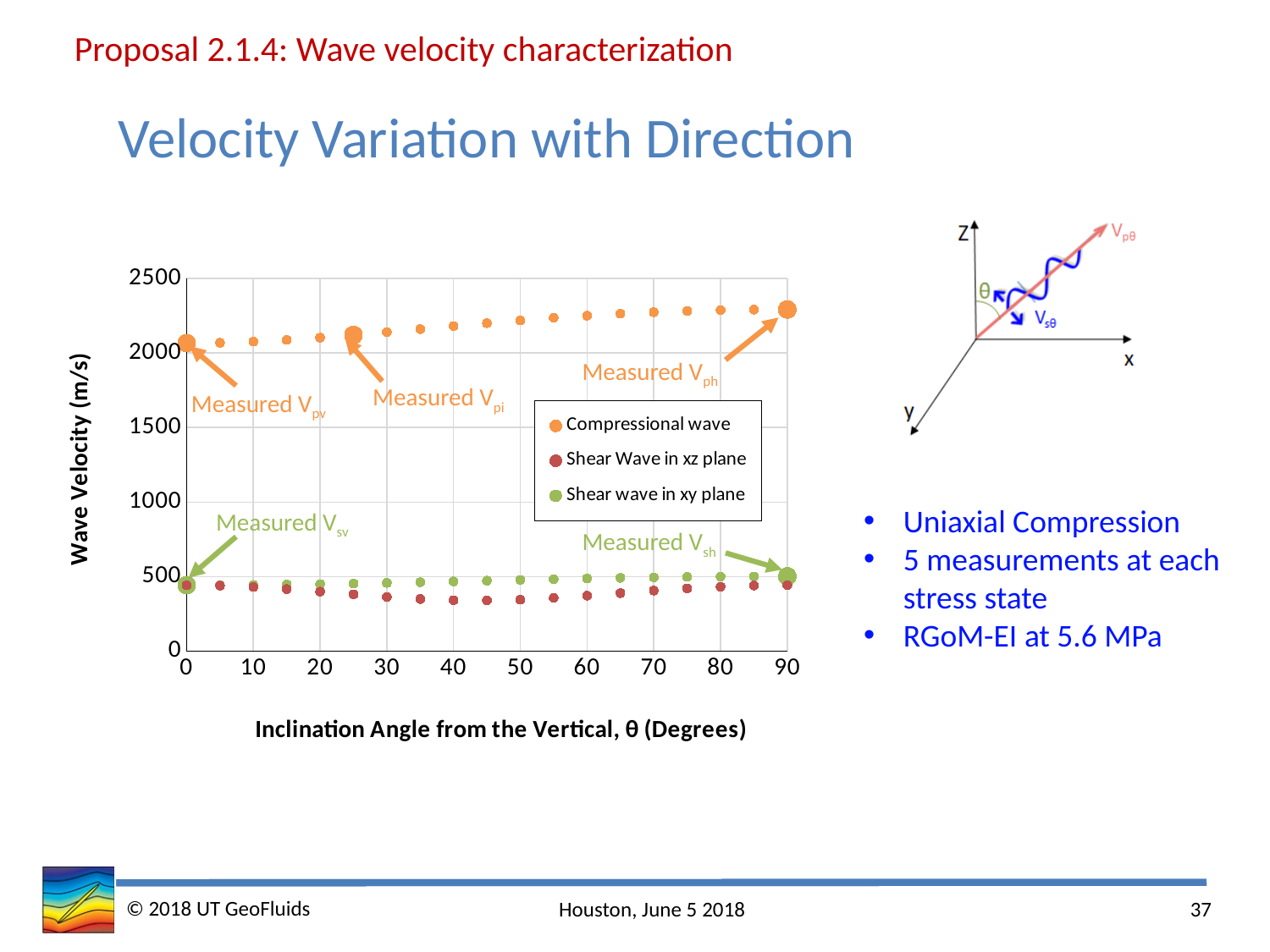
Do the Compressional wave values rise or fall as the inclination angle increases from 0 to 90 degrees? rise What is the title of the y axis? Wave Velocity (m/s) At 90 degrees, which is larger: the Compressional wave value or the Shear wave in xy plane value? Compressional wave How many series does the legend list? 3 Is the Compressional wave value at 90 degrees greater or less than 2500? less How many data points are plotted for each series along the x axis? 19 What are the three series listed in the legend? Compressional wave, Shear Wave in xz plane, Shear wave in xy plane Which series has the highest wave velocity values? Compressional wave What kind of chart is shown on the slide? scatter chart At which inclination angle is the Compressional wave velocity highest? 90 Is the Compressional wave value at 90 degrees greater or less than 2000? greater Is the Shear Wave in xz plane value at 45 degrees greater or less than 500? less